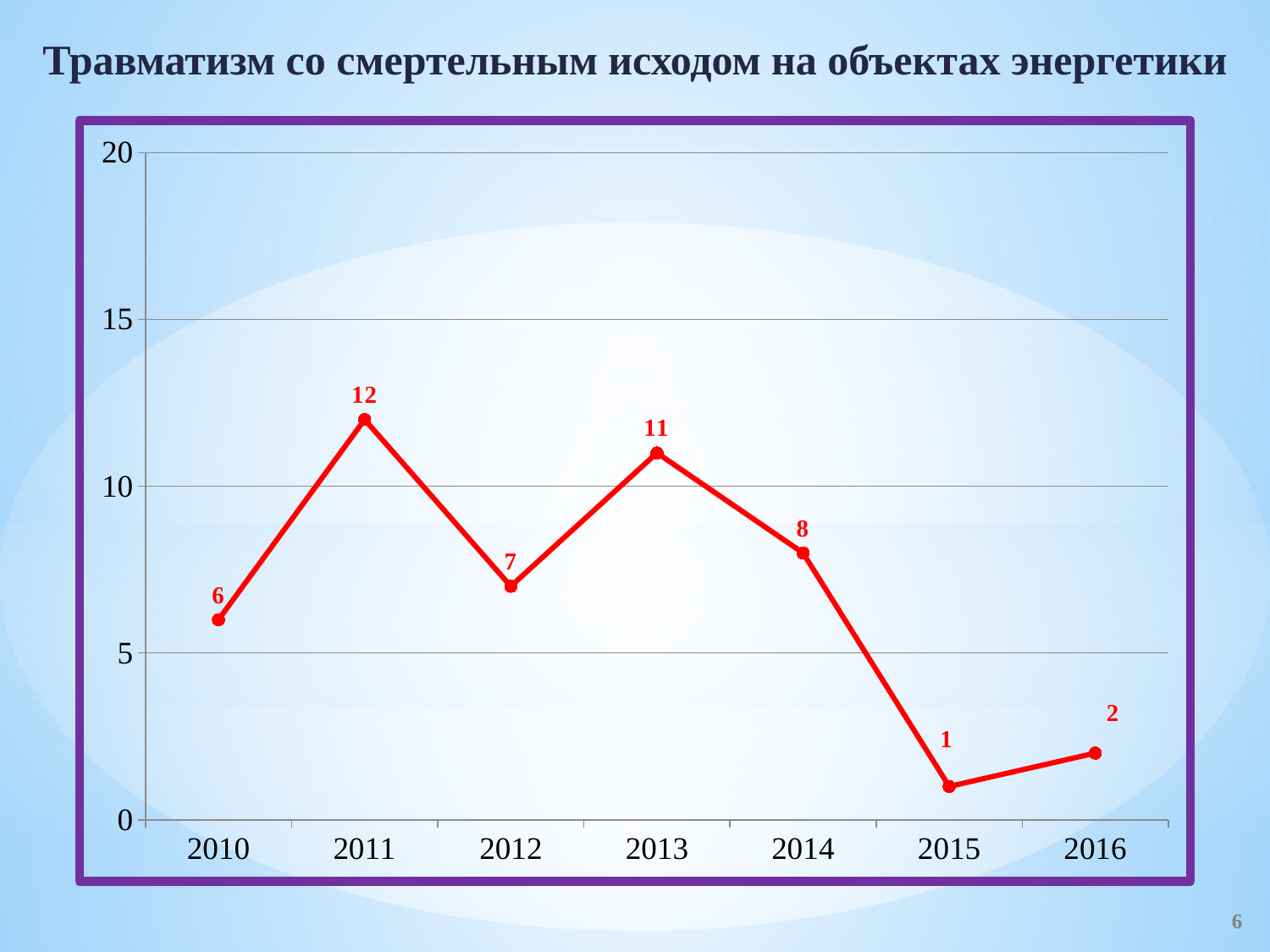
What kind of chart is shown on the slide? line chart What is the value for 2013? 11 Is the value for 2013 greater or less than 10? greater Which is larger, the value for 2010 or the value for 2012? 2012 What is the value for 2011? 12 What is the difference between the values for 2014 and 2016? 6 What is the value for 2015? 1 Which year has the highest value? 2011 Do the values rise or fall from 2013 to 2015? fall What is the difference between the values for 2011 and 2012? 5 How many years are plotted on the chart? 7 Which year has the lowest value? 2015